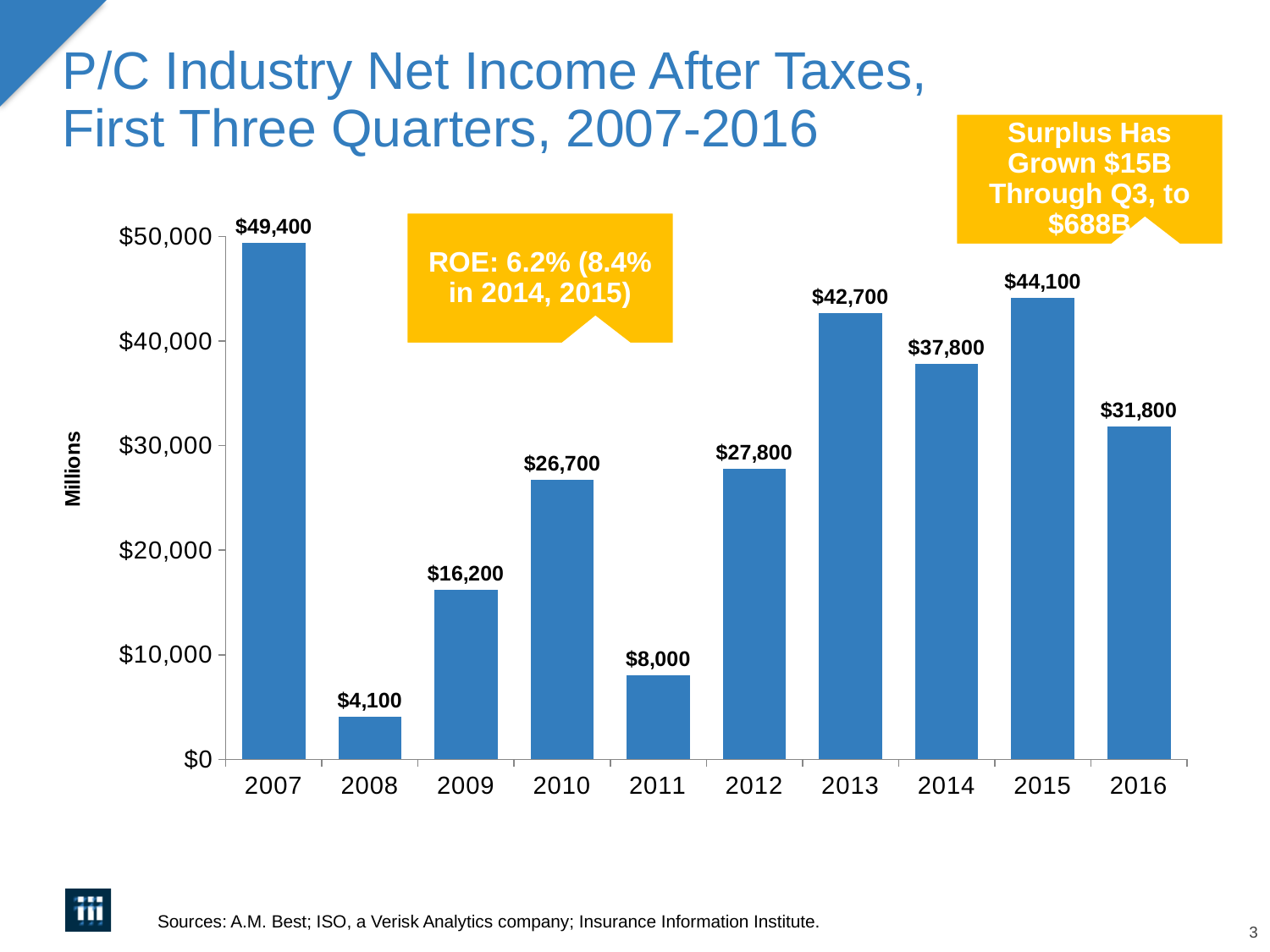
What is the value shown for 2011? $8,000 Which is larger, the value for 2010 or the value for 2012? 2012 What is the net income after taxes for the first three quarters of 2007? $49,400 What is the difference between the values for 2013 and 2012? $14,900 Is the value for 2009 greater or less than $20,000? less What is the difference between the values for 2015 and 2014? $6,300 How many years are shown on the chart? 10 Which year has the lowest net income after taxes? 2008 Which year has the highest net income after taxes? 2007 What is the label on the vertical axis? Millions What kind of chart is shown on the slide? bar chart What is the value shown for 2016? $31,800